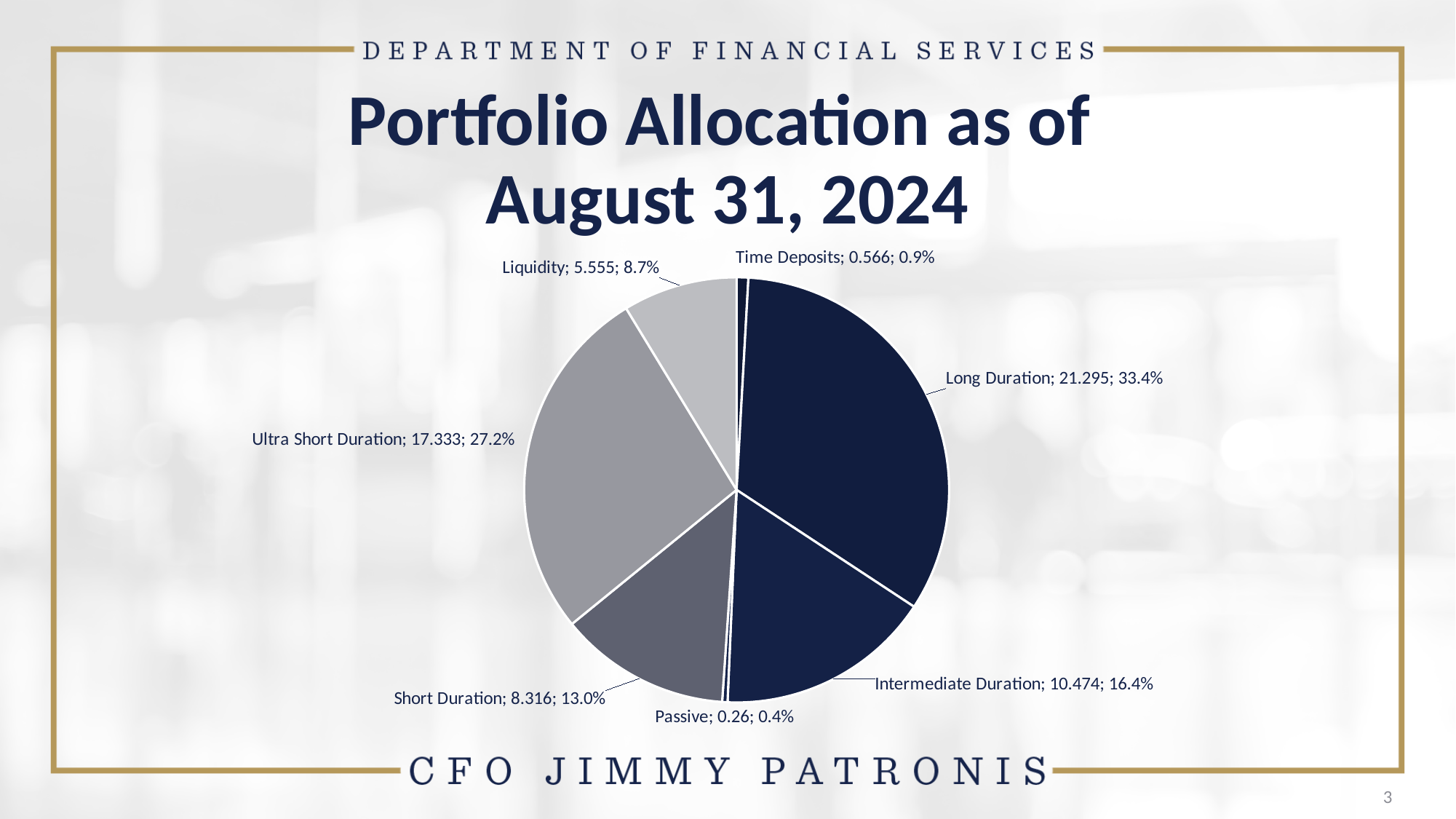
What is the value for Short Duration? 8.316 What is the difference between the values for Long Duration and Intermediate Duration? 10.821 Which category has the smallest slice? Passive What is the title of the chart? Portfolio Allocation as of August 31, 2024 What percentage share does Ultra Short Duration have? 27.2% What is the value for Long Duration? 21.295 Which is larger, Liquidity or Short Duration? Short Duration How many categories are shown in the pie chart? 7 Which category has the largest slice? Long Duration What kind of chart is shown on the slide? pie chart What percentage share does Time Deposits have? 0.9% What percentage share does Intermediate Duration have? 16.4%